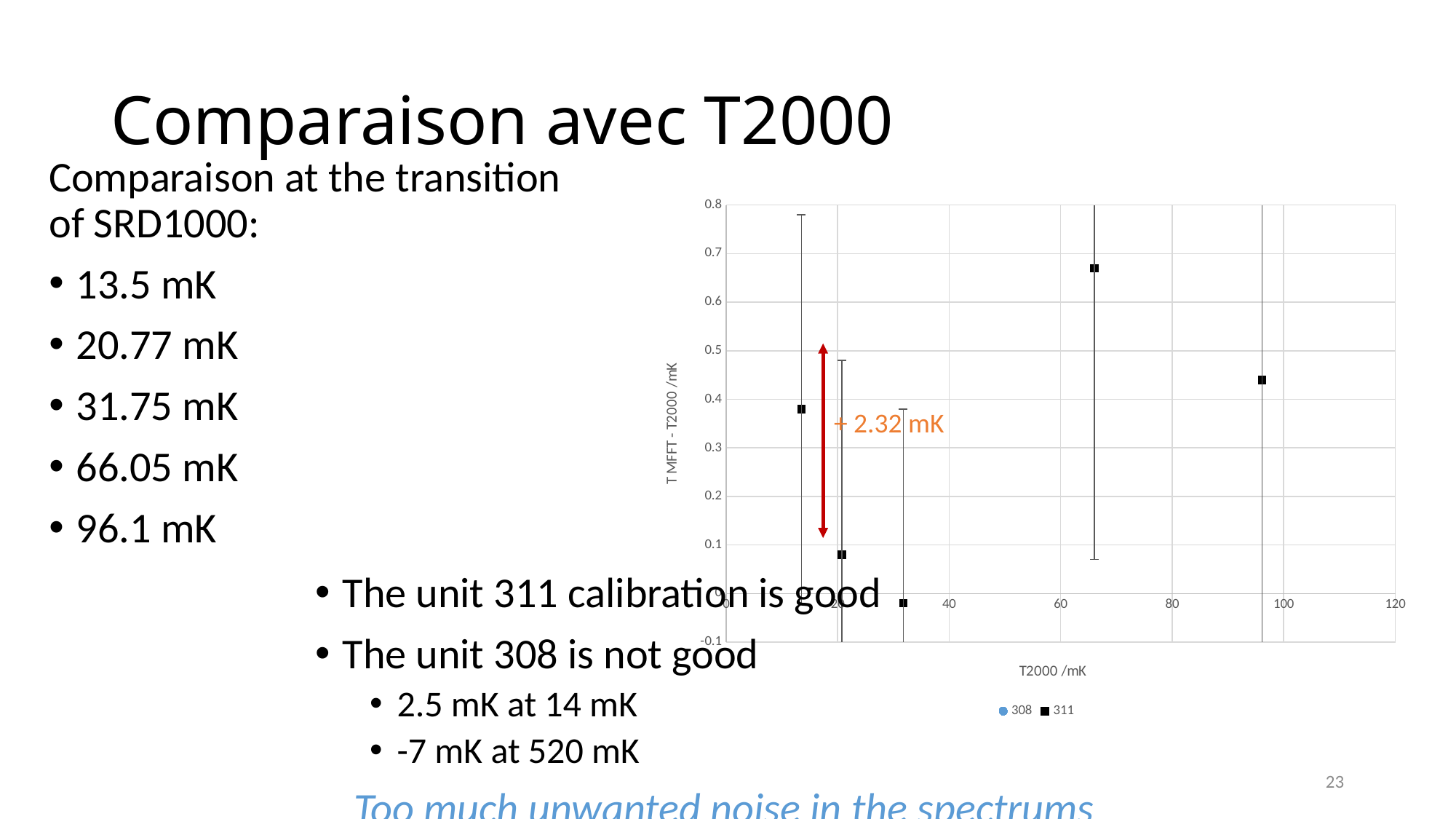
Is the value of the 311 point near 96 mK on the x axis greater or less than 0.5? less What value is written next to the red double-headed arrow on the chart? + 2.32 mK What kind of chart is shown on the slide? scatter chart What are the two series names in the chart legend? 308 and 311 Which plotted point has the highest y value: the one near 66 mK or the one near 96 mK on the x axis? the one near 66 mK How many series does the chart legend list? 2 Is the value of the 311 point near 14 mK on the x axis greater or less than 0.3? greater How many black square data points are plotted on the chart? 5 Which plotted point has the lowest y value on the chart? the one near 32 mK on the x axis Is the value of the 311 point near 20 mK on the x axis greater or less than 0.2? less What is the title of the x axis of the chart? T2000 /mK